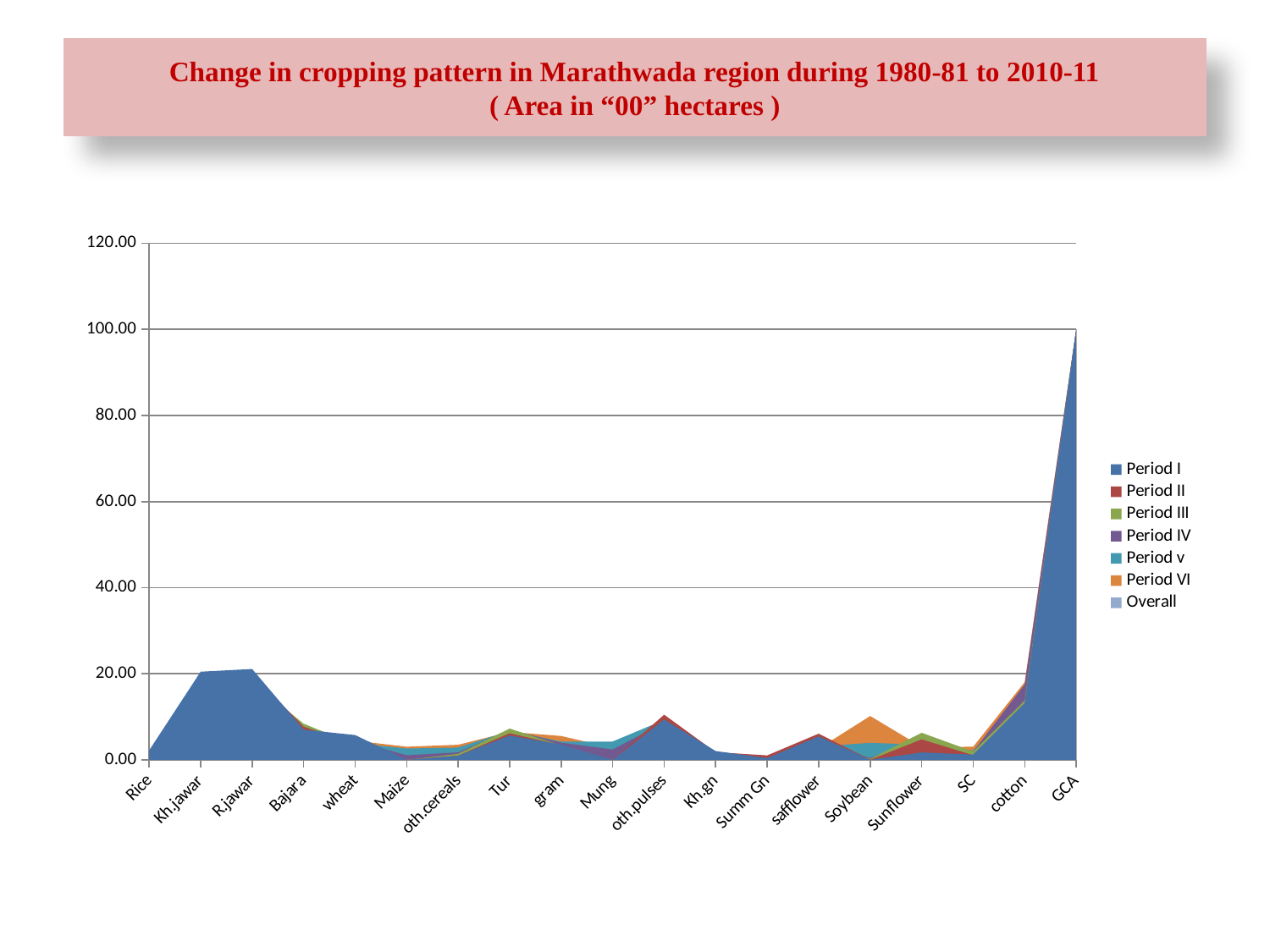
Is the value for GCA greater or less than 80.00? greater What is the title of the chart on the slide? Change in cropping pattern in Marathwada region during 1980-81 to 2010-11 ( Area in "00" hectares ) Which category has the highest value in the chart? GCA How many crop categories are shown along the x axis? 19 What kind of chart is shown on the slide? area chart How many series does the legend list? 7 What is the last entry listed in the legend? Overall Which is larger, the value for Kh.jawar or the value for Rice? Kh.jawar Is the value for cotton greater or less than 40.00? less Which is larger, the value for GCA or the value for cotton? GCA Is the value for Rice greater or less than 20.00? less